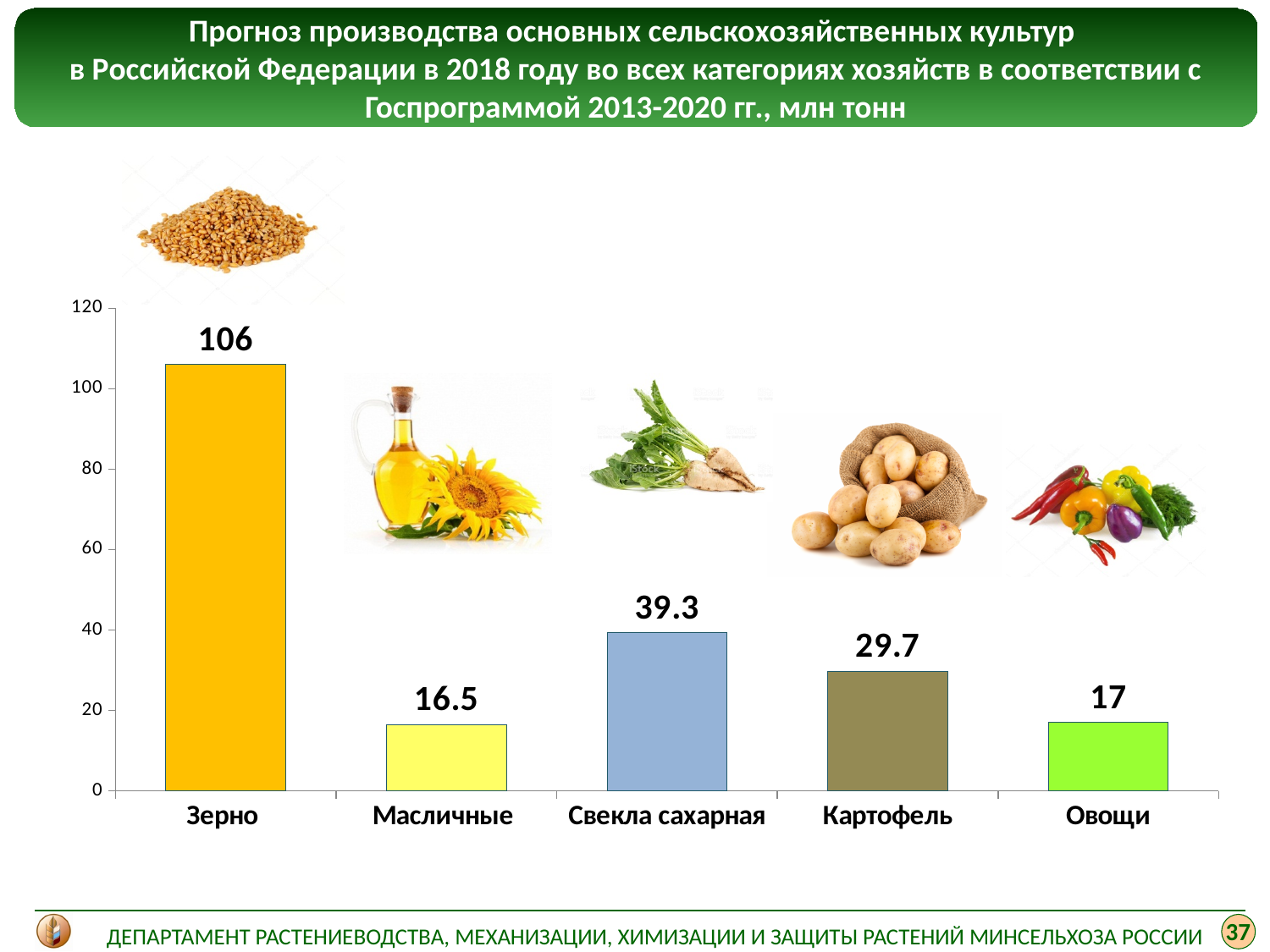
Which category has the highest value? Зерно What kind of chart is shown on the slide? bar chart What colour is the bar for Свекла сахарная? light blue What is the value for Картофель? 29.7 Which category has the lowest value? Масличные How many categories are shown on the chart? 5 What is the value for Масличные? 16.5 Which is larger, the value for Овощи or the value for Масличные? Овощи What is the value for Свекла сахарная? 39.3 What is the difference between the values for Свекла сахарная and Картофель? 9.6 What is the value for Зерно? 106 Is the value for Зерно greater or less than 100? greater